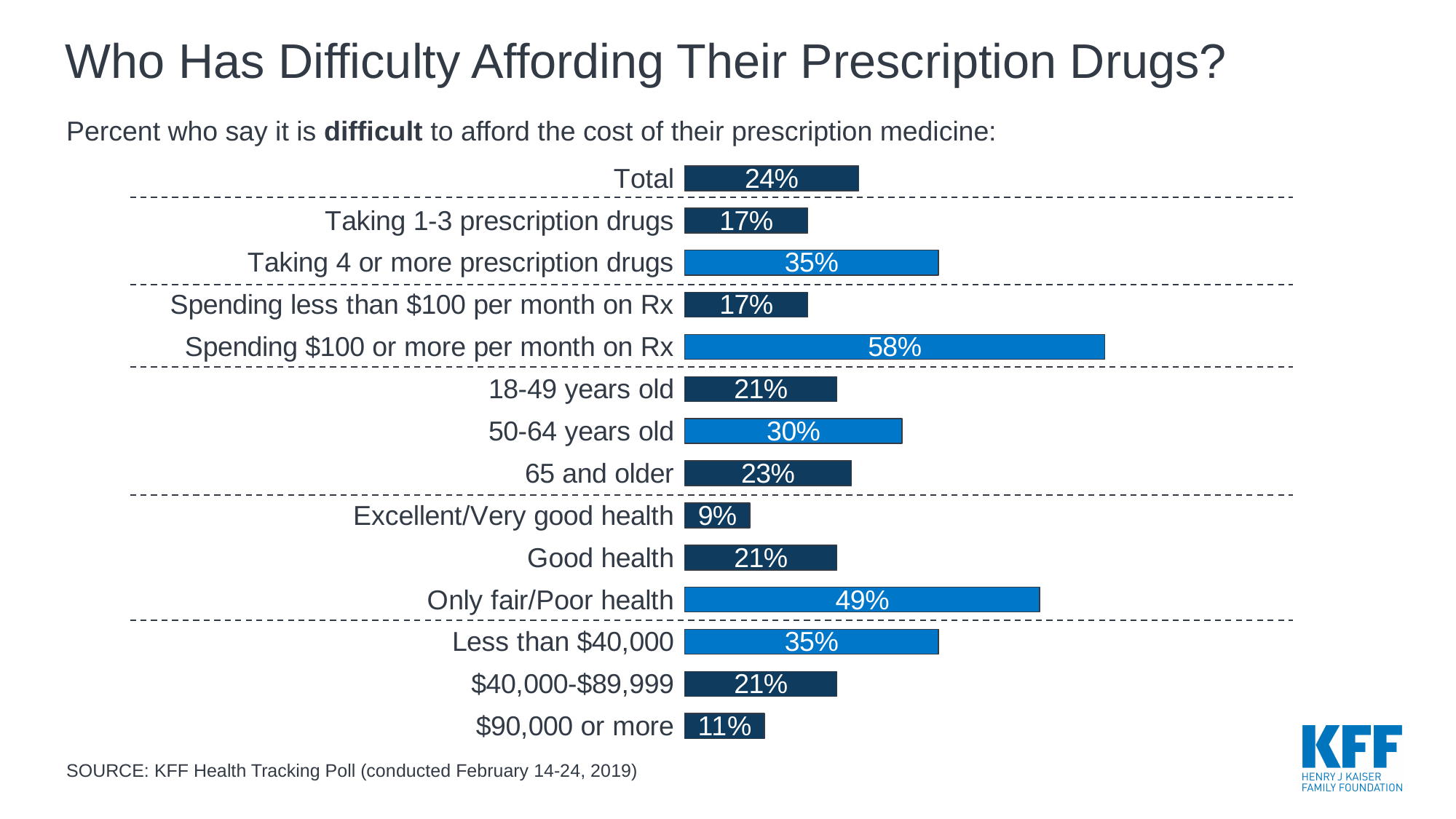
What is the value for those with income of $90,000 or more? 11% What is the difference between the values for Taking 4 or more prescription drugs and Taking 1-3 prescription drugs? 18 percentage points What is the difference between the values for Only fair/Poor health and Good health? 28 percentage points Which is larger, the value for 50-64 years old or the value for 65 and older? 50-64 years old What is the value for those spending $100 or more per month on Rx? 58% Which category has the lowest percent saying it is difficult to afford their prescription medicine? Excellent/Very good health What is the value for people in Excellent/Very good health? 9% What is the source cited for the chart? KFF Health Tracking Poll (conducted February 14-24, 2019) Which category has the highest percent saying it is difficult to afford their prescription medicine? Spending $100 or more per month on Rx What kind of chart is shown on the slide? Bar chart What percent of the Total say it is difficult to afford the cost of their prescription medicine? 24% How many categories (bars) are shown in the chart? 14